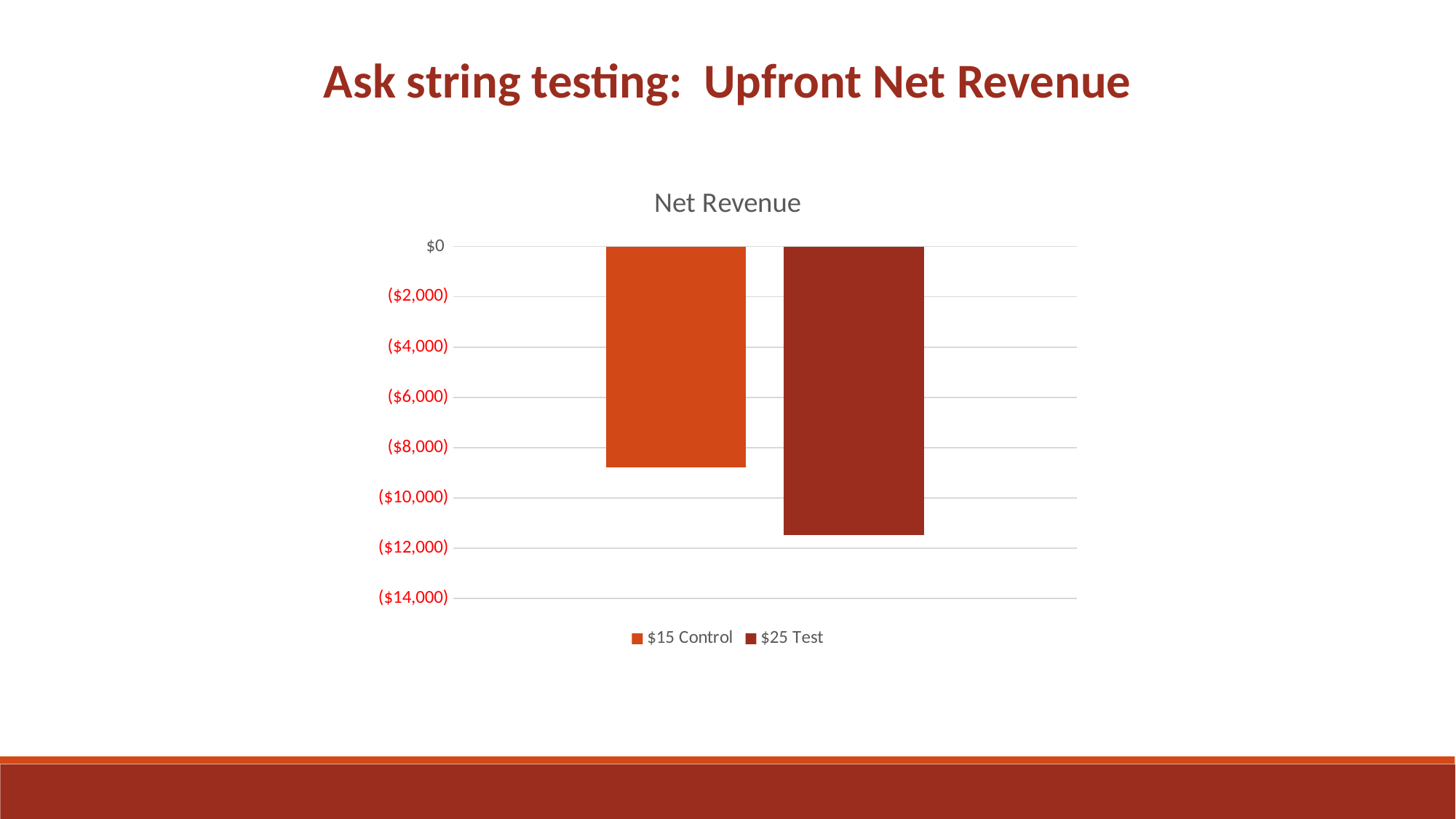
Is the value for $15 Control greater or less than ($8,000)? less Is the value for $25 Test greater or less than ($12,000)? greater Which is larger, the net revenue for $15 Control or for $25 Test? $15 Control What kind of chart is shown on the slide? bar chart Which series has the highest net revenue? $15 Control How many bars are plotted in the Net Revenue chart? 2 Is the value for $15 Control greater or less than ($10,000)? greater How many series does the legend list in the Net Revenue chart? 2 What is the title of the chart? Net Revenue What are the two series named in the legend? $15 Control and $25 Test Which series has the lowest (most negative) net revenue? $25 Test